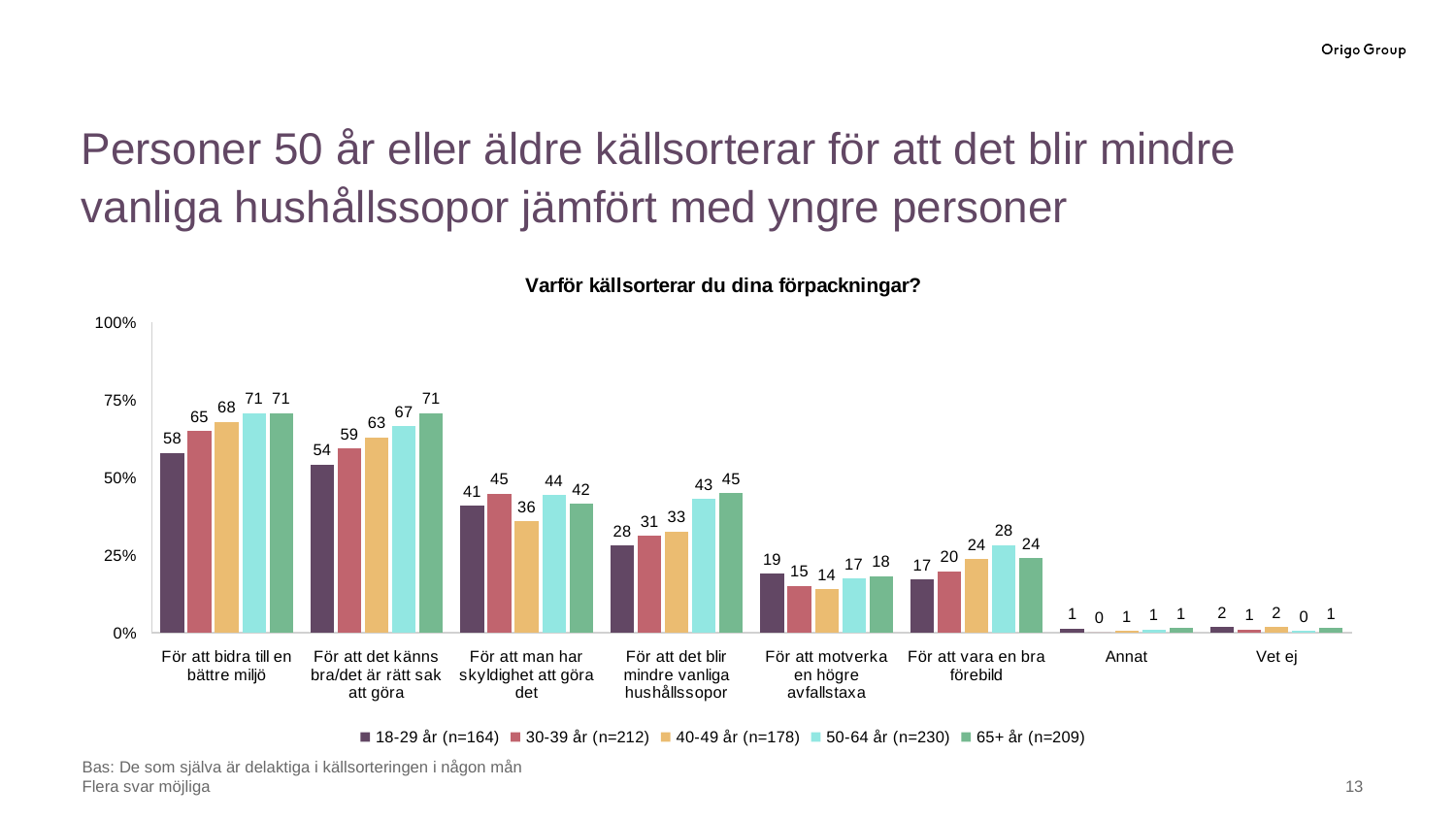
What is the difference between the 65+ år and 18-29 år values in the category "För att det blir mindre vanliga hushållssopor"? 17 What is the value for the 65+ år series in the category "För att det blir mindre vanliga hushållssopor"? 45 What is the value for the 40-49 år series in the category "För att man har skyldighet att göra det"? 36 In the category "För att motverka en högre avfallstaxa", which is larger: the value for 18-29 år or for 40-49 år? 18-29 år Which age group has the highest value in the category "För att det känns bra/det är rätt sak att göra"? 65+ år (n=209) What is the title of the chart? Varför källsorterar du dina förpackningar? What kind of chart is shown on the slide? Bar chart What is the value for the 18-29 år series in the category "För att bidra till en bättre miljö"? 58 How many series does the legend list? 5 Which age group has the lowest value in the category "För att vara en bra förebild"? 18-29 år (n=164) Do the values for the 50-64 år series rise or fall across the first four categories from left to right? Fall How many categories are shown on the x axis? 8